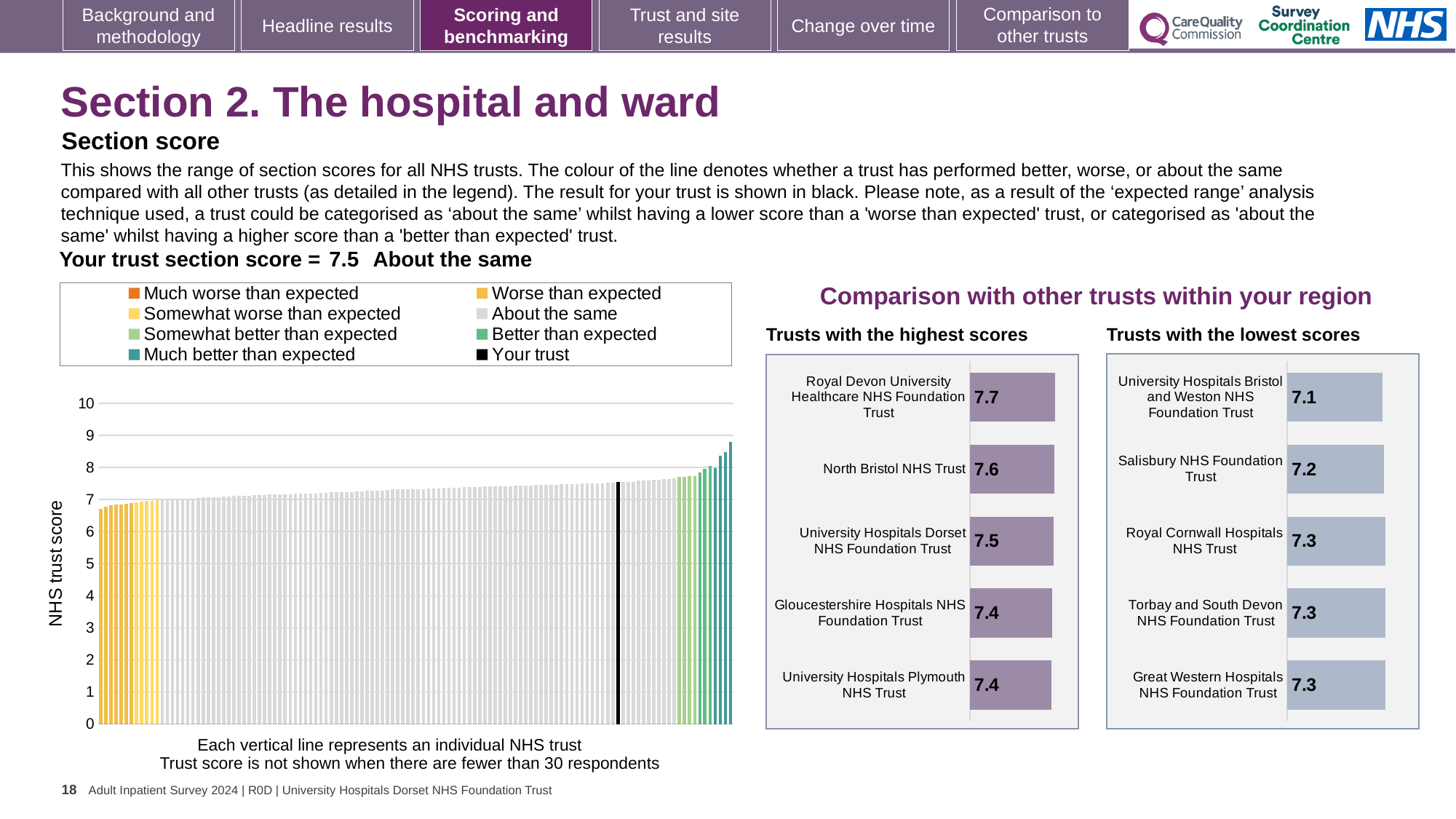
How many trusts are shown in the 'Trusts with the highest scores' chart? 5 In the 'Trusts with the highest scores' chart, what is the score for Royal Devon University Healthcare NHS Foundation Trust? 7.7 In the 'Trusts with the lowest scores' chart, which has the larger score: Salisbury NHS Foundation Trust or Royal Cornwall Hospitals NHS Trust? Royal Cornwall Hospitals NHS Trust In the 'Trusts with the highest scores' chart, what is the difference between the scores of Royal Devon University Healthcare NHS Foundation Trust and University Hospitals Plymouth NHS Trust? 0.3 What kind of chart is the 'Trusts with the lowest scores' chart? bar chart In the main 'NHS trust score' chart, do the trust scores rise or fall from left to right? rise In the 'Trusts with the highest scores' chart, which trust has the highest score? Royal Devon University Healthcare NHS Foundation Trust How many entries does the legend of the main 'NHS trust score' chart list? 8 In the 'Trusts with the lowest scores' chart, which trust has the lowest score? University Hospitals Bristol and Weston NHS Foundation Trust In the 'Trusts with the lowest scores' chart, what is the score for Salisbury NHS Foundation Trust? 7.2 In the main 'NHS trust score' chart, is the value of the rightmost (highest) bar greater or less than 8? greater In the main 'NHS trust score' chart, what is the section score for your trust? 7.5